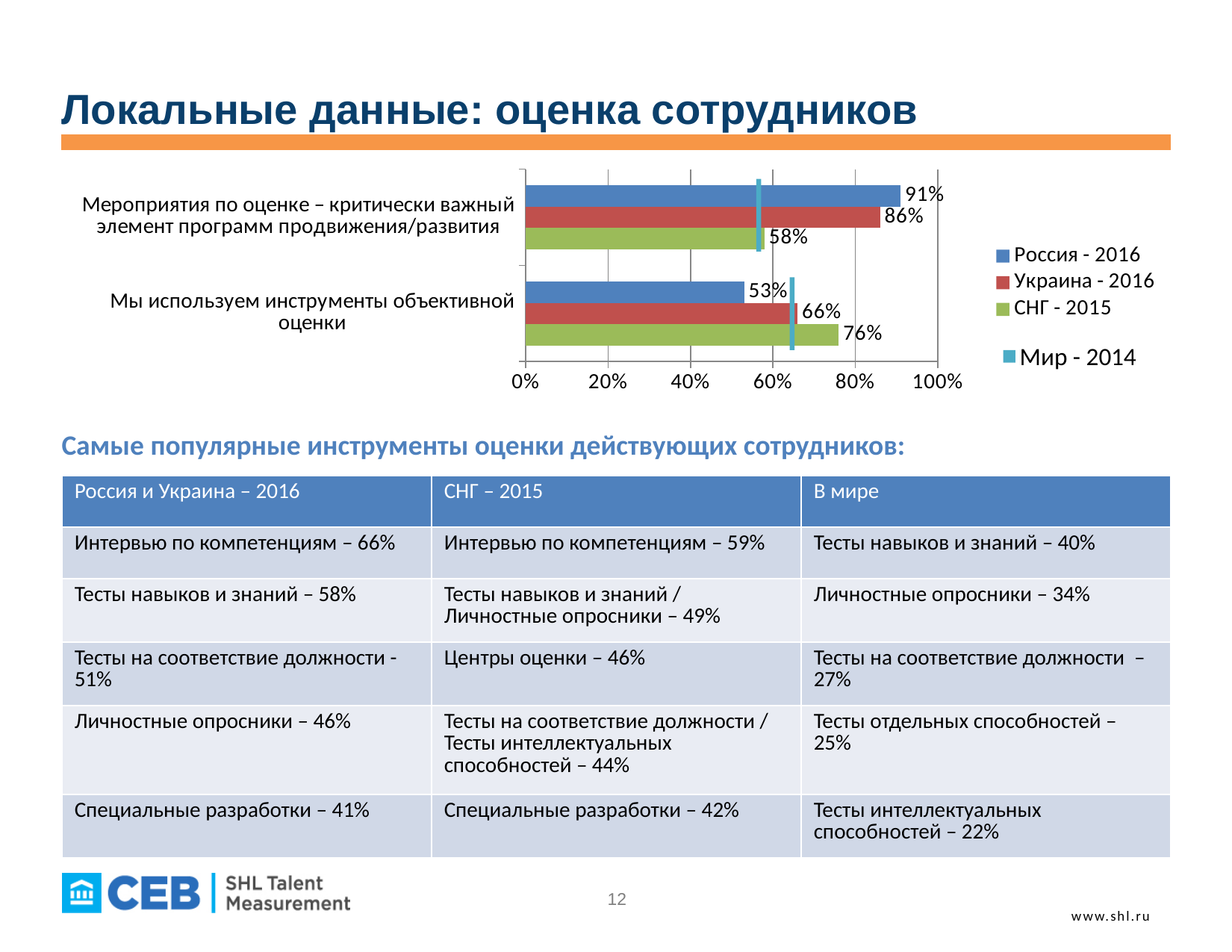
For the category 'Мы используем инструменты объективной оценки', which is larger: the Россия - 2016 value or the Украина - 2016 value? Украина - 2016 Which series has the highest value for the category 'Мы используем инструменты объективной оценки'? СНГ - 2015 How many categories are shown on the chart? 2 What is the value for Россия - 2016 for the category 'Мероприятия по оценке – критически важный элемент программ продвижения/развития'? 91% What is the value for СНГ - 2015 for the category 'Мероприятия по оценке – критически важный элемент программ продвижения/развития'? 58% What is the value for СНГ - 2015 for the category 'Мы используем инструменты объективной оценки'? 76% What kind of chart is shown on the slide? bar chart Is the Мир - 2014 value for the category 'Мероприятия по оценке – критически важный элемент программ продвижения/развития' greater or less than 80%? less What is the value for Украина - 2016 for the category 'Мы используем инструменты объективной оценки'? 66% How many series does the chart legend list? 4 What is the difference between the Россия - 2016 and Украина - 2016 values for the category 'Мероприятия по оценке – критически важный элемент программ продвижения/развития'? 5%